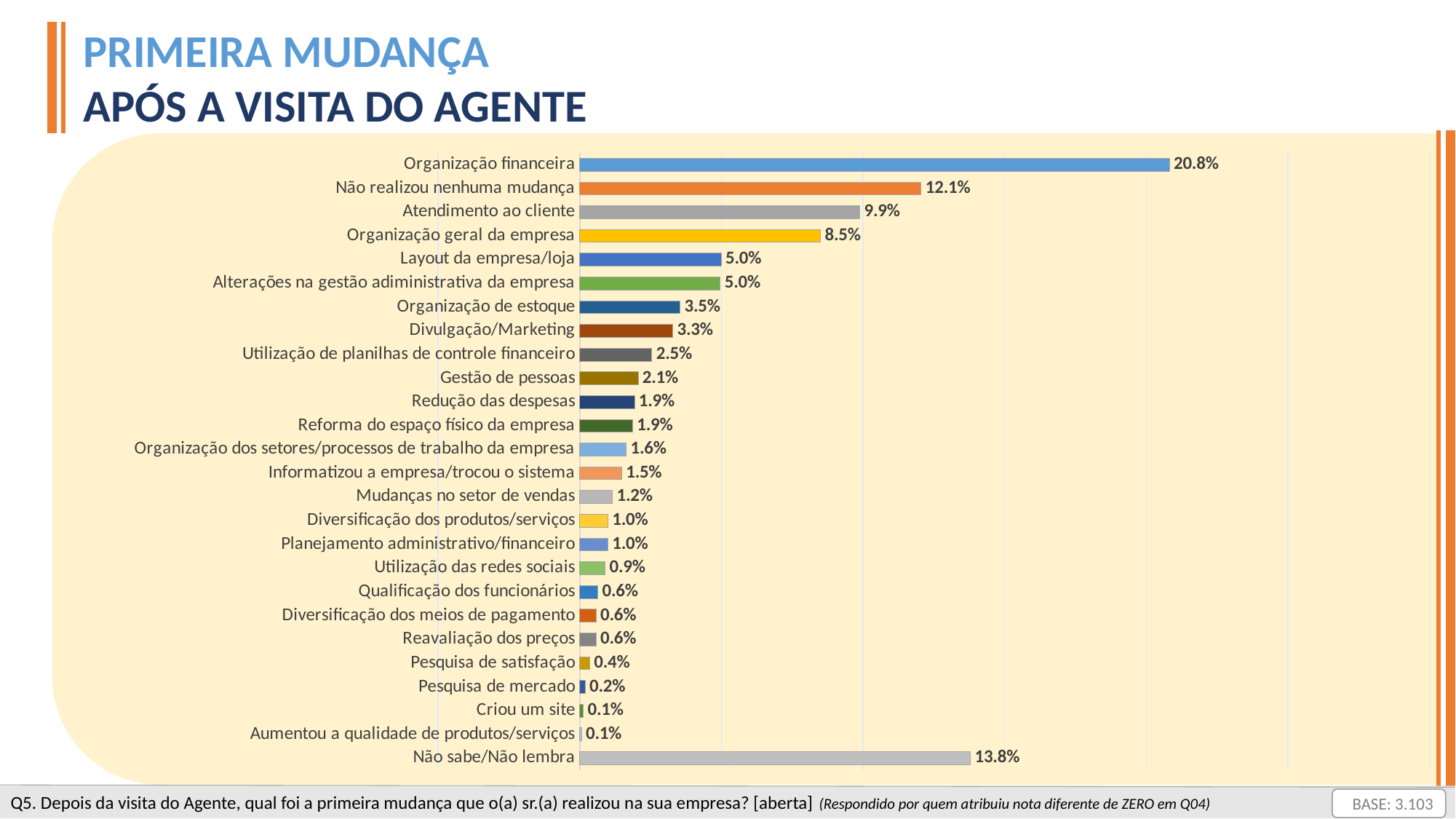
Which is larger, Não sabe/Não lembra or Não realizou nenhuma mudança? Não sabe/Não lembra What kind of chart is shown on the slide? Bar chart What is the value for Divulgação/Marketing? 3.3% What is the difference between Organização financeira and Não realizou nenhuma mudança? 8.7% Which is larger, Organização de estoque or Gestão de pessoas? Organização de estoque What is the value for Não sabe/Não lembra? 13.8% What is the difference between Organização geral da empresa and Layout da empresa/loja? 3.5% What is the value for Atendimento ao cliente? 9.9% What is the value for Pesquisa de mercado? 0.2% What is the value for Organização financeira? 20.8% Which category has the highest value? Organização financeira How many categories are shown in the chart? 26